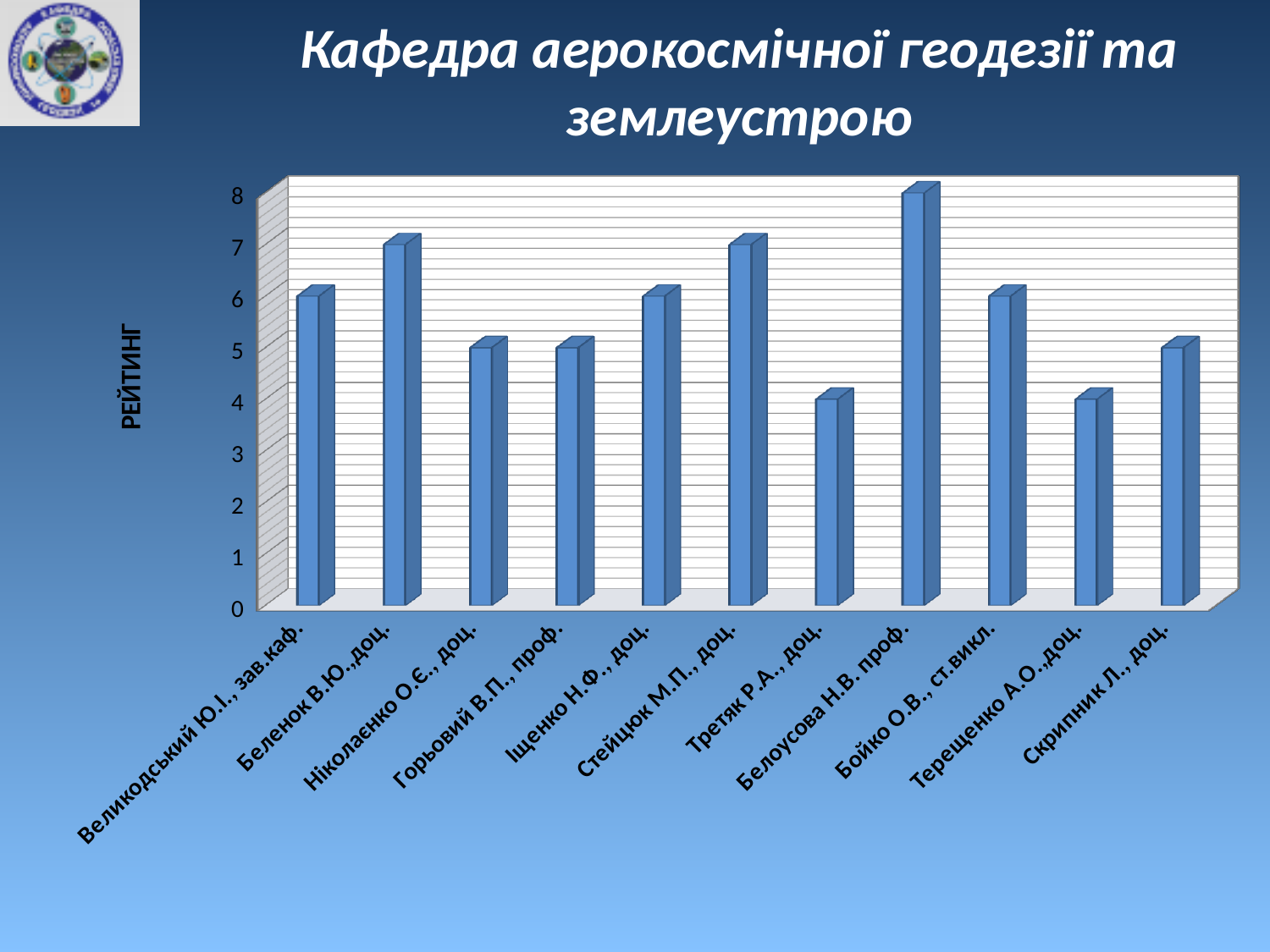
What is the rating value for Третяк Р.А., доц.? 4 What is the rating value for Белоусова Н.В. проф.? 8 What is the rating value for Великодський Ю.І., зав.каф.? 6 What is the difference between the ratings of Белоусова Н.В. проф. and Ніколаєнко О.Є., доц.? 3 What is the title of the slide containing the chart? Кафедра аерокосмічної геодезії та землеустрою Is the rating for Бойко О.В., ст.викл. greater or less than 5? greater What type of chart is shown on the slide? bar chart What is the rating value for Беленок В.Ю., доц.? 7 Which has a higher rating: Стейцюк М.П., доц. or Терещенко А.О., доц.? Стейцюк М.П., доц. How many staff members (categories) are shown on the chart? 11 Which staff member has the highest rating on the chart? Белоусова Н.В. проф. What is the label on the vertical axis of the chart? РЕЙТИНГ